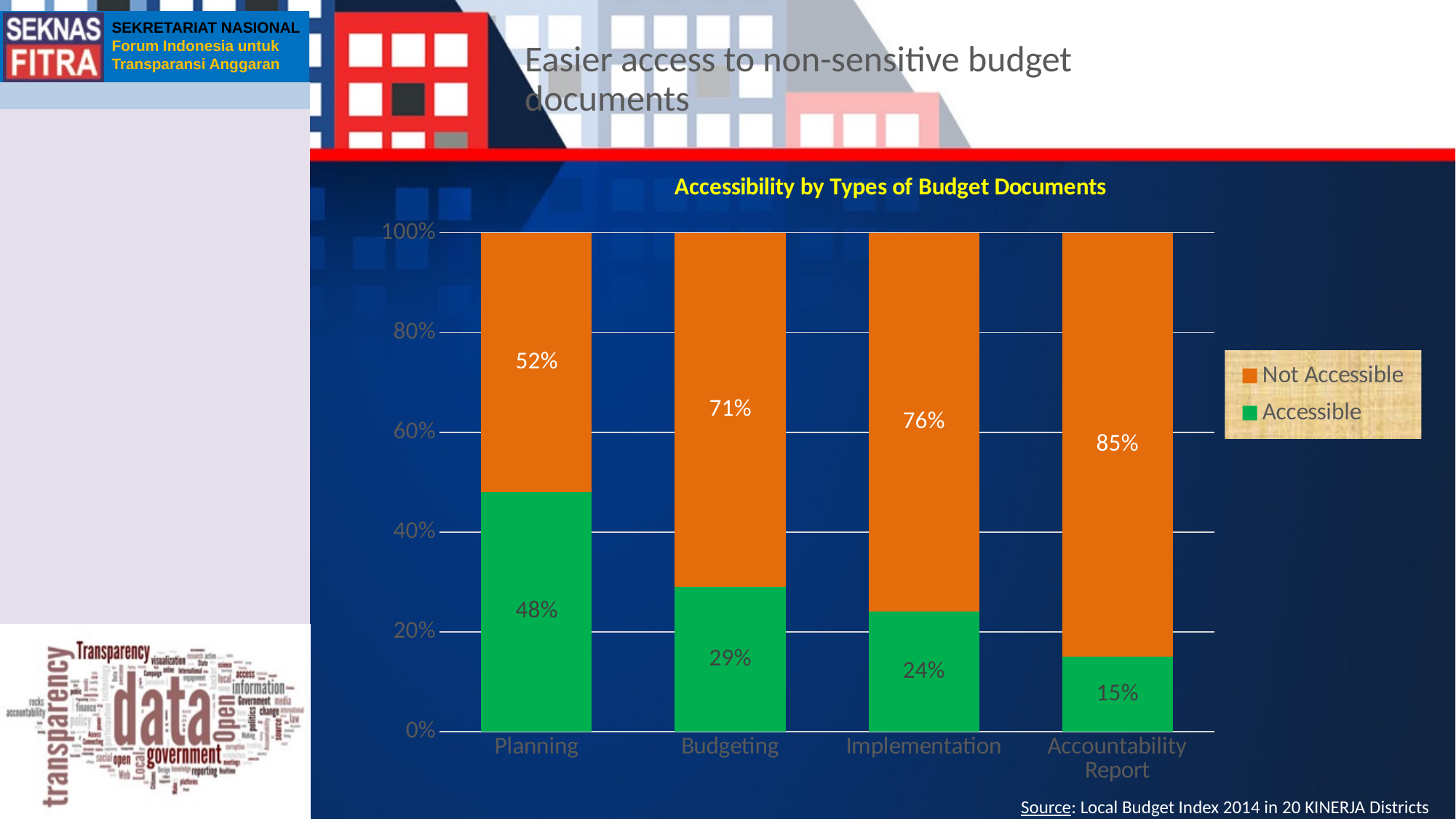
Which category has the lowest Accessible value? Accountability Report Which is larger, the Accessible value for Budgeting or for Implementation? Budgeting What is the title of the chart? Accessibility by Types of Budget Documents What is the Accessible value for Planning? 48% How many categories are shown on the x axis? 4 What is the difference between the Not Accessible values for Budgeting and Planning? 19% What kind of chart is shown? Stacked bar chart What is the Accessible value for Implementation? 24% What is the Not Accessible value for Accountability Report? 85% Do the Accessible values rise or fall from Planning to Accountability Report? Fall How many series does the legend list? 2 Which category has the highest Accessible value? Planning